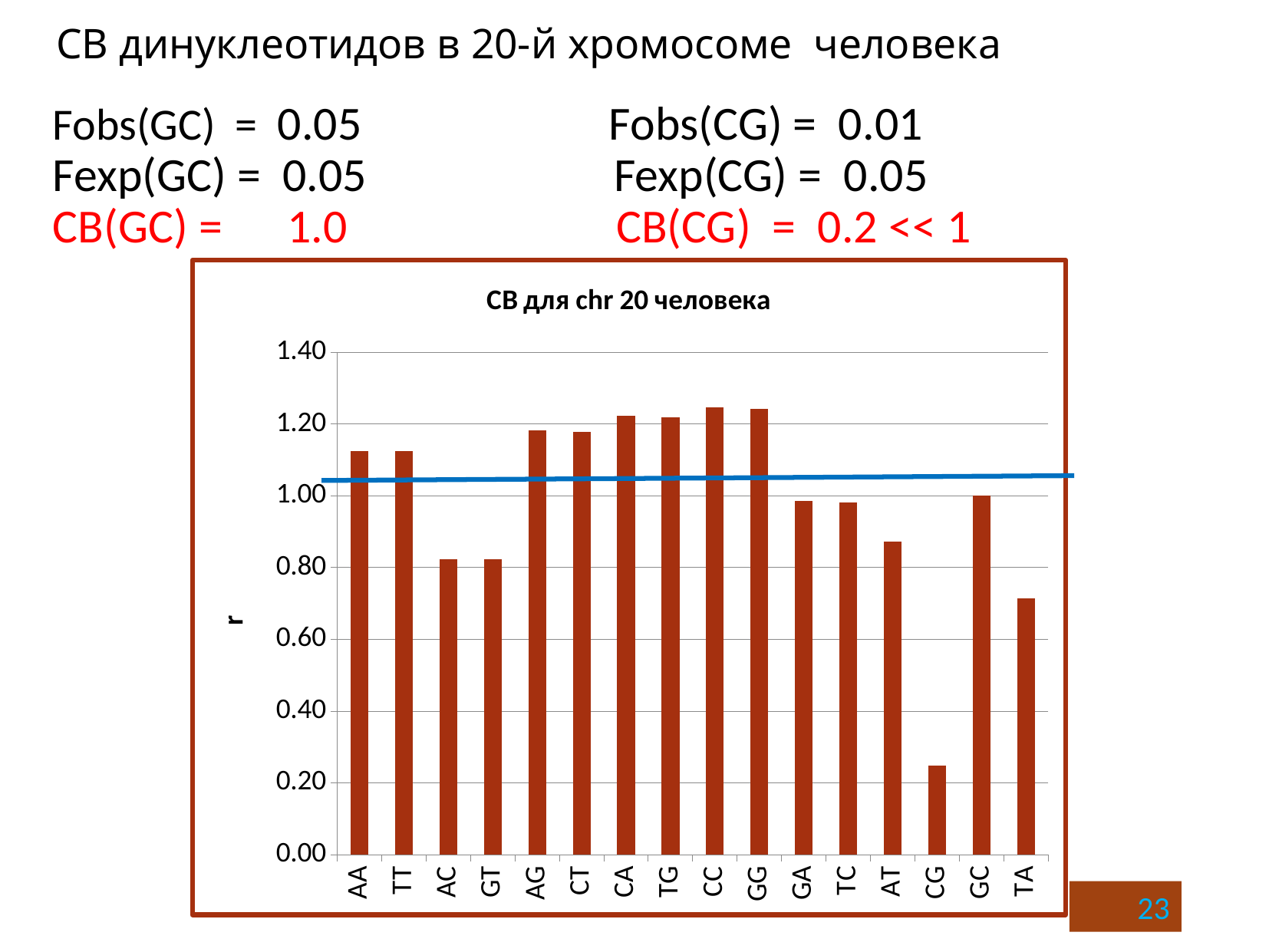
Which has the larger value, AA or AC? AA Which has the larger value, CG or TA? TA Is the value for AA greater or less than 1.00? greater What kind of chart is shown on the slide? bar chart Is the value for AC greater or less than 1.00? less What is the title of the chart? СВ для chr 20 человека Which category has the lowest bar in the chart? CG Is the value for TA greater or less than 0.80? less How many dinucleotide categories are shown on the x axis of the chart? 16 What is the label on the vertical axis of the chart? r